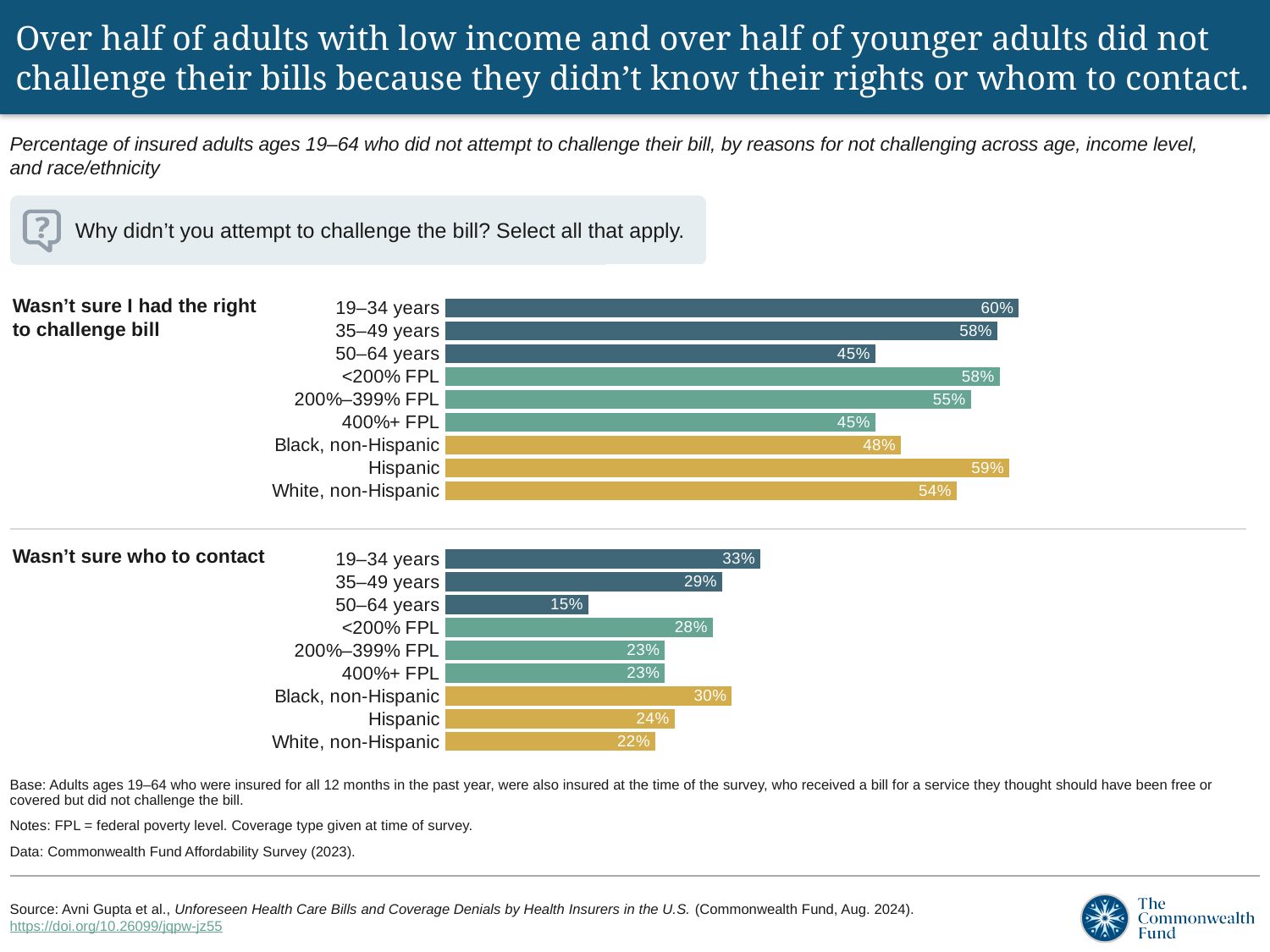
In the 'Wasn't sure I had the right to challenge bill' chart, which is larger: <200% FPL or 200%–399% FPL? <200% FPL In the 'Wasn't sure who to contact' chart, which is larger: Black, non-Hispanic or Hispanic? Black, non-Hispanic In the 'Wasn't sure I had the right to challenge bill' chart, what is the value for Black, non-Hispanic? 48% In the 'Wasn't sure I had the right to challenge bill' chart, which category has the lowest value? 50–64 years and 400%+ FPL (both 45%) How many categories are shown in the 'Wasn't sure who to contact' chart? 9 What kind of chart is used on this slide? Bar chart In the 'Wasn't sure who to contact' chart, which category has the highest value? 19–34 years In the 'Wasn't sure I had the right to challenge bill' chart, what is the value for 19–34 years? 60% In the 'Wasn't sure who to contact' chart, what is the value for 50–64 years? 15% In the 'Wasn't sure who to contact' chart, which category has the lowest value? 50–64 years In the 'Wasn't sure I had the right to challenge bill' chart, what is the difference between Hispanic and White, non-Hispanic? 5 percentage points In the 'Wasn't sure who to contact' chart, what is the difference between 19–34 years and 50–64 years? 18 percentage points